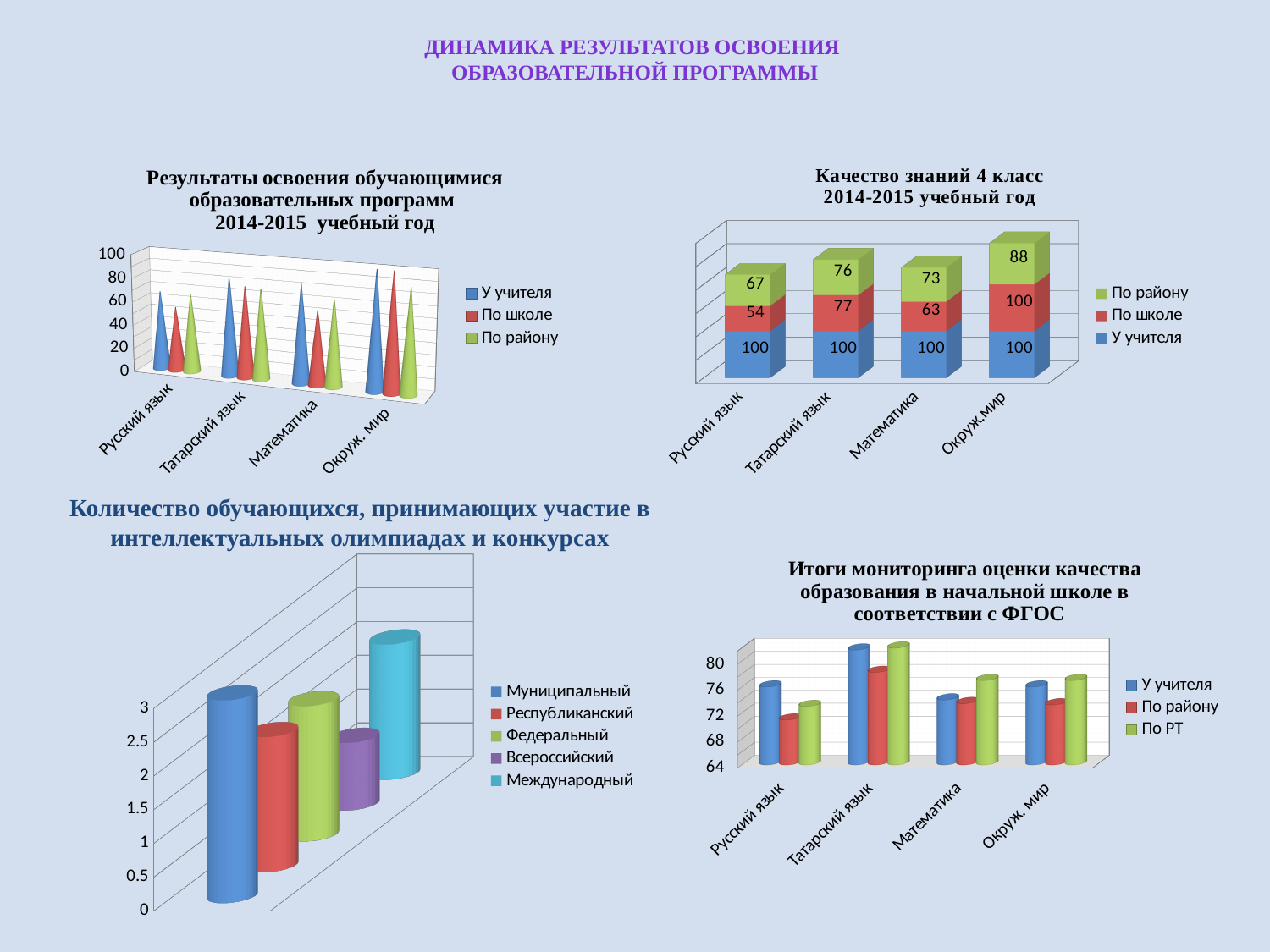
In the chart 'Качество знаний 4 класс 2014-2015 учебный год', which category has the lowest 'По школе' value? Русский язык How many categories are shown on the x axis of the chart 'Итоги мониторинга оценки качества образования в начальной школе в соответствии с ФГОС'? 4 In the chart 'Качество знаний 4 класс 2014-2015 учебный год', what is the value of 'По школе' for Математика? 63 In the chart 'Итоги мониторинга оценки качества образования в начальной школе в соответствии с ФГОС', is the value of 'По РТ' for Татарский язык greater or less than 76? greater How many series does the legend list in the chart 'Количество обучающихся, принимающих участие в интеллектуальных олимпиадах и конкурсах'? 5 In the chart 'Качество знаний 4 класс 2014-2015 учебный год', is the 'По району' value for Татарский язык larger or smaller than the 'По школе' value for Татарский язык? smaller In the chart 'Качество знаний 4 класс 2014-2015 учебный год', which category has the highest 'По району' value? Окруж.мир In the chart 'Качество знаний 4 класс 2014-2015 учебный год', what is the difference between the 'По школе' values for Татарский язык and Математика? 14 In the chart 'Качество знаний 4 класс 2014-2015 учебный год', what is the value of 'По району' for Окруж.мир? 88 In the chart 'Качество знаний 4 класс 2014-2015 учебный год', what is the value of 'По школе' for Русский язык? 54 In the chart 'Качество знаний 4 класс 2014-2015 учебный год', what is the total of the stacked bar for Окруж.мир? 288 In the chart 'Результаты освоения обучающимися образовательных программ 2014-2015 учебный год', is the value of 'У учителя' for Окруж. мир greater or less than 60? greater